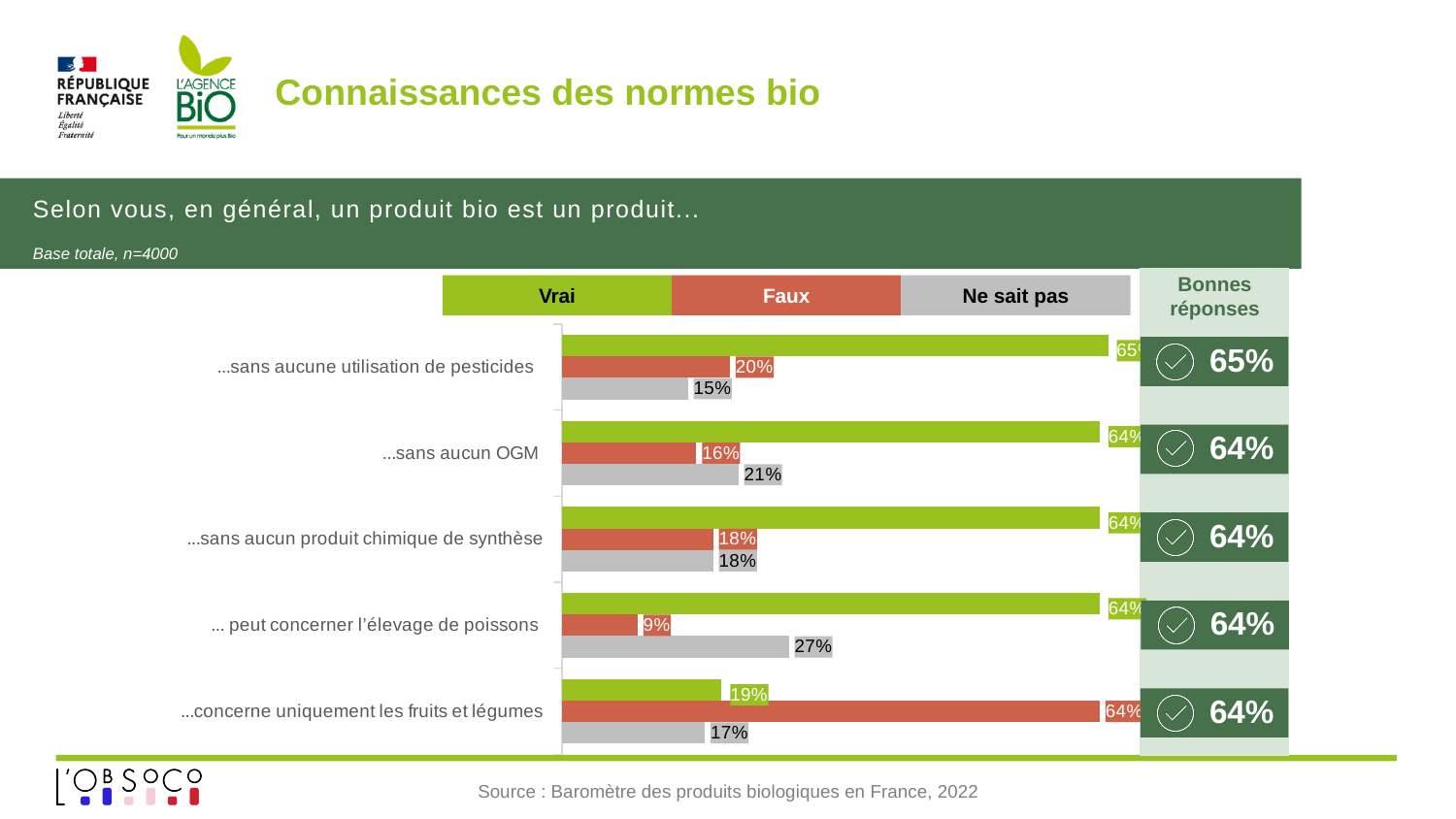
What type of chart is shown on the slide? Bar chart What is the "Ne sait pas" value for "... peut concerner l'élevage de poissons"? 27% How many statements (categories) are shown in the chart? 5 What is the "Faux" value for "...sans aucun OGM"? 16% What percentage of respondents answered "Vrai" for "...sans aucune utilisation de pesticides"? 65% What is the "Faux" value for "...concerne uniquement les fruits et légumes"? 64% What is the difference between the "Vrai" and "Faux" values for "...sans aucune utilisation de pesticides"? 45 percentage points How many series does the legend list? 3 What is the "Bonnes réponses" value shown for "...sans aucun produit chimique de synthèse"? 64% Which category has the highest "Ne sait pas" value? ... peut concerner l'élevage de poissons Which category has the lowest "Faux" value? ... peut concerner l'élevage de poissons For "...sans aucun OGM", which is larger: the "Faux" value or the "Ne sait pas" value? Ne sait pas